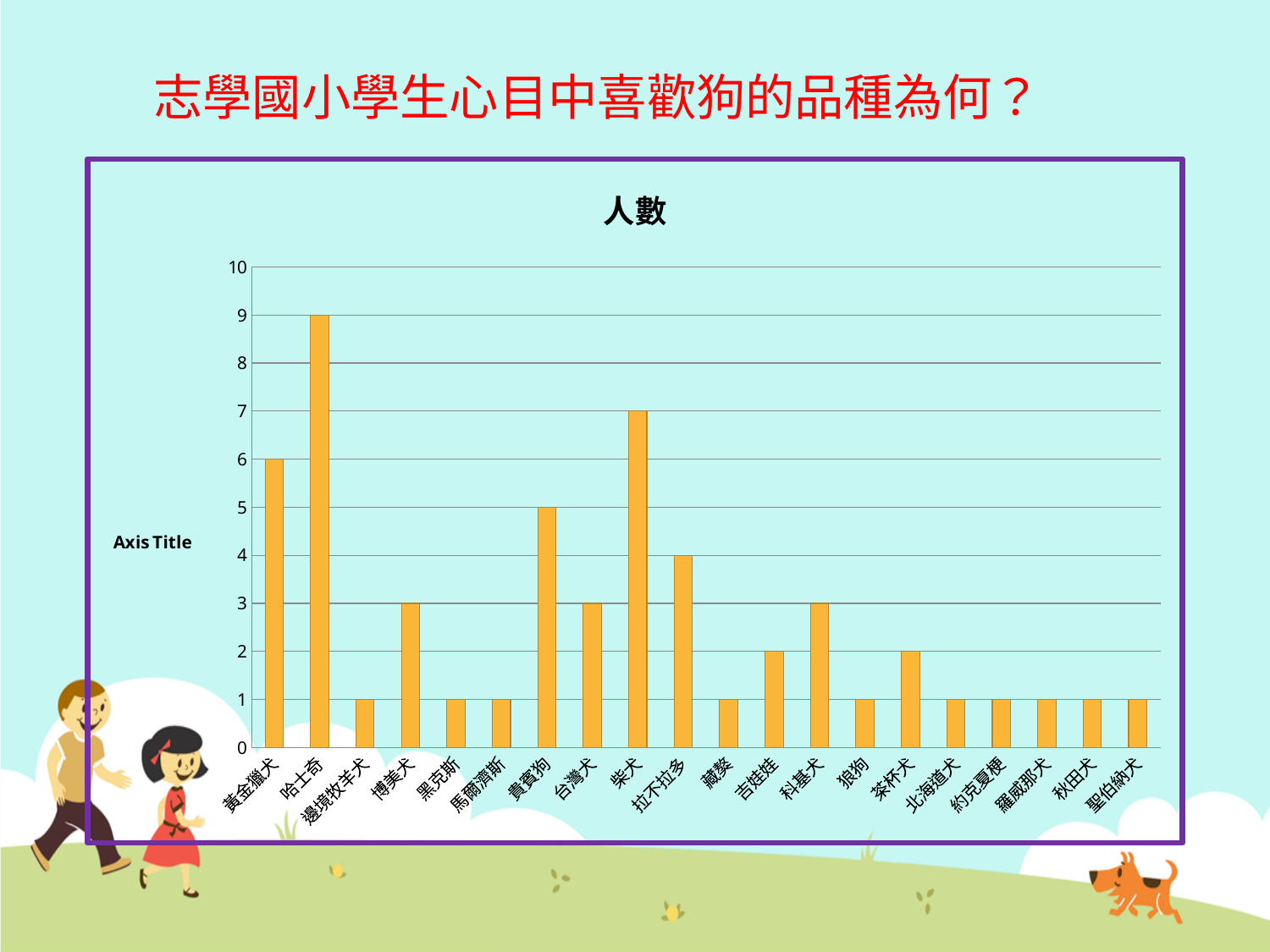
What is the value for 柴犬? 7 What is the value for 拉不拉多? 4 What is the value for 哈士奇? 9 What is the difference between the values for 哈士奇 and 柴犬? 2 Which has a larger value, 黃金獵犬 or 貴賓狗? 黃金獵犬 Which dog breed has the highest value? 哈士奇 Is the value for 柴犬 greater or less than 5? greater What is the value for 黃金獵犬? 6 How many dog breeds (categories) are shown on the x axis? 20 What kind of chart is shown on the slide? bar chart What is the title of the chart? 人數 Is the value for 吉娃娃 greater or less than 5? less